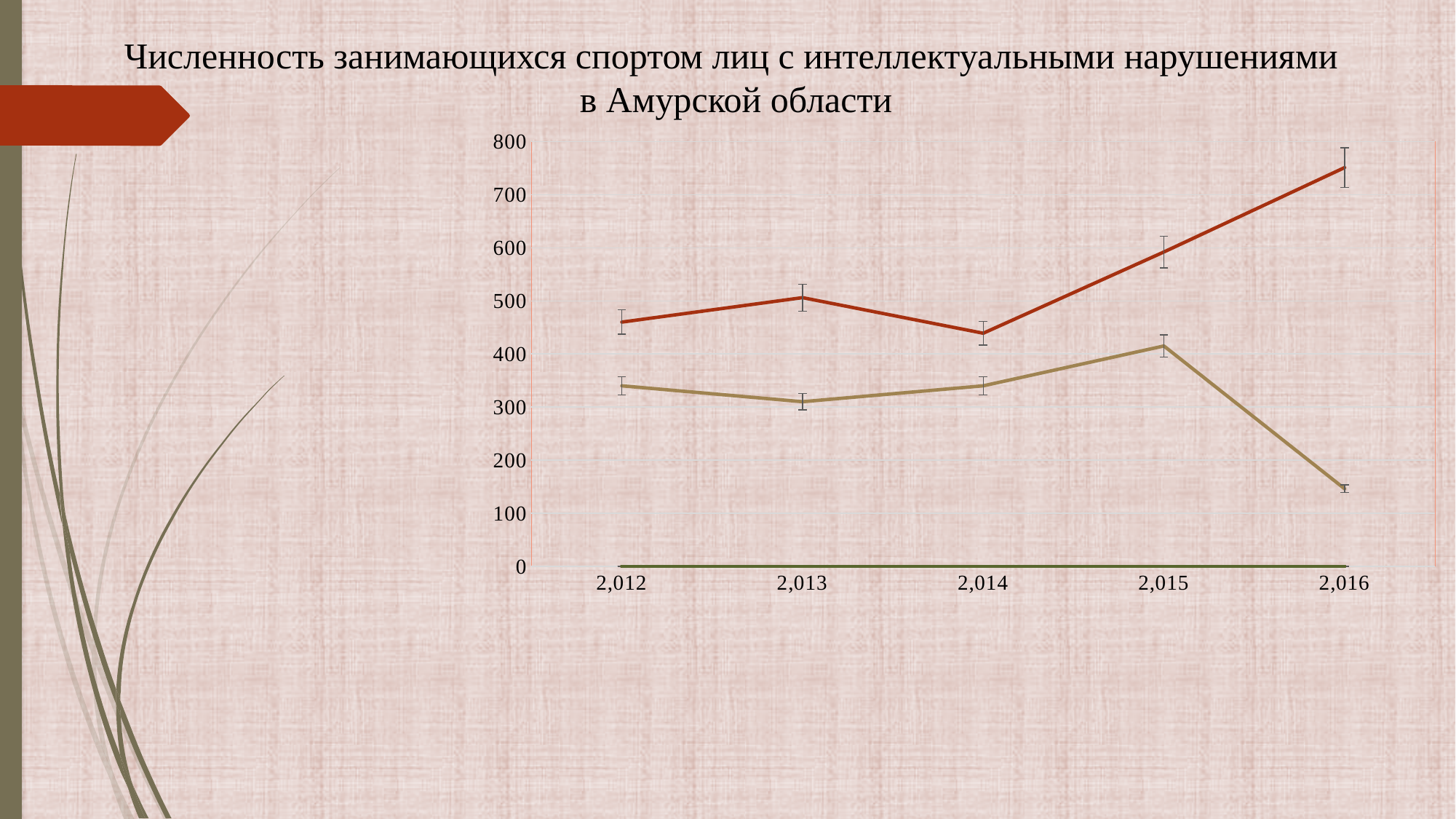
Is the value of the red line for 2,016 greater or less than 700? greater Is the value of the red line for 2,013 greater or less than 400? greater How many lines are plotted on the chart? 2 How many years are shown on the x axis of the chart? 5 Is the value of the tan (lower) line for 2,016 greater or less than 200? less What kind of chart is shown on the slide? line chart In which year does the red line reach its highest value? 2,016 In which year does the tan line reach its lowest value? 2,016 Does the red line rise or fall from 2,014 to 2,016? rise At 2,015, which line has the higher value, the red line or the tan line? the red line In which year does the tan line reach its highest value? 2,015